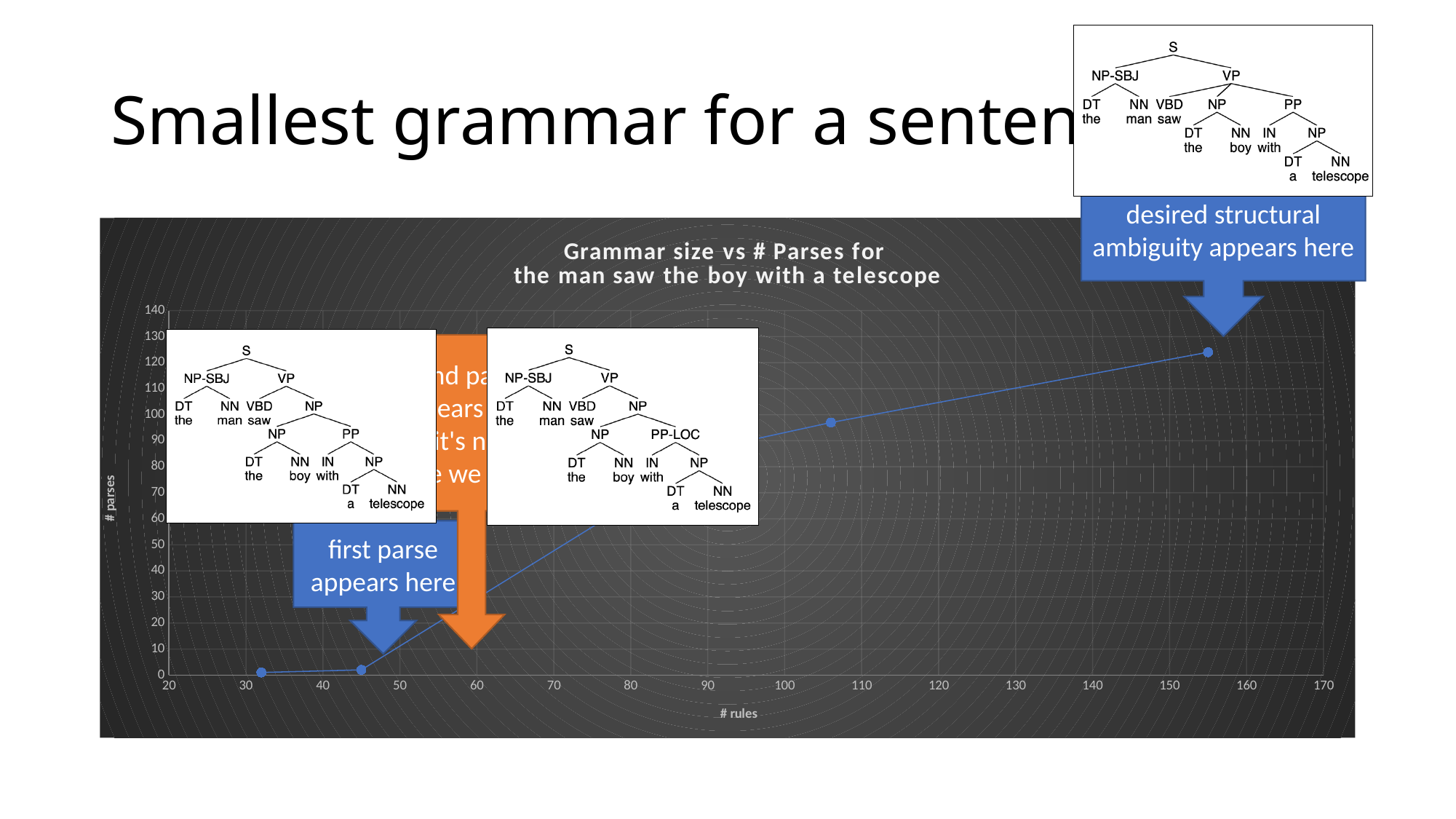
Is the number of parses for the rightmost data point (around 155 rules) greater or less than 100? greater Is the number of parses for the data point at around 45 rules greater or less than 20? less What is the label of the x axis of the chart? # rules What is the highest value shown on the y axis of the chart? 140 Which data point has the highest number of parses: the one at around 106 rules or the one at around 155 rules? the one at around 155 rules Is the number of parses for the leftmost data point (around 32 rules) greater or less than 10? less What kind of chart is shown on the slide? line chart Does the number of parses rise or fall as the number of rules increases along the x axis? rise What is the title of the chart? Grammar size vs # Parses for the man saw the boy with a telescope